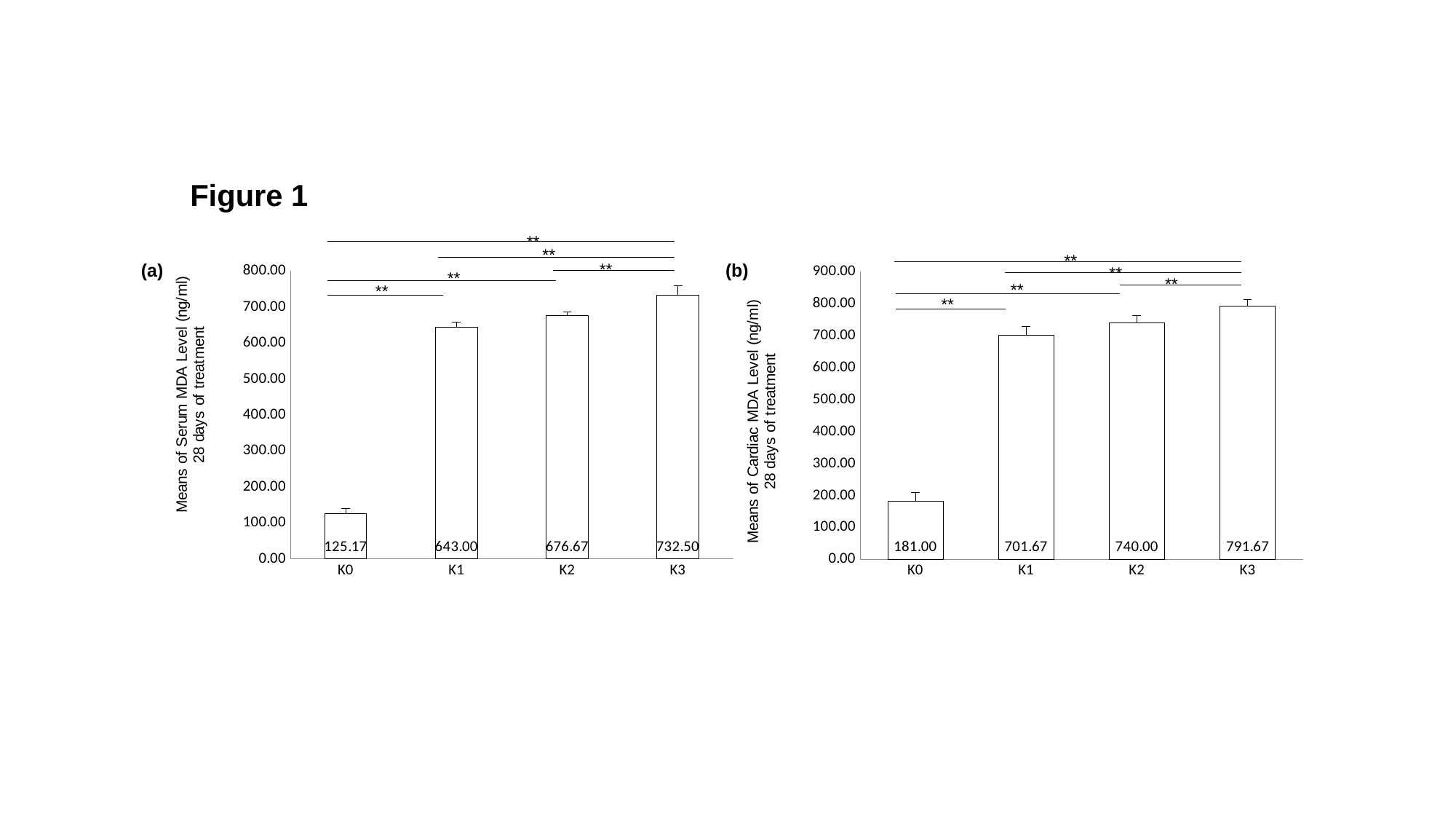
What kind of chart is chart (b), the cardiac MDA chart on the right? bar chart In chart (a), the serum MDA chart on the left, which is larger, the value for K2 or the value for K1? K2 How many categories are shown on the x axis of chart (a), the serum MDA chart on the left? 4 In chart (a), the serum MDA chart on the left, do the values rise or fall from K0 to K3? rise In chart (b), the cardiac MDA chart on the right, what is the value for K2? 740.00 What is the y-axis label of chart (b), the chart on the right? Means of Cardiac MDA Level (ng/ml) 28 days of treatment In chart (b), the cardiac MDA chart on the right, is the value for K0 greater or less than 300.00? less In chart (b), the cardiac MDA chart on the right, which category has the highest value? K3 In chart (a), the serum MDA chart on the left, which category has the lowest value? K0 In chart (b), the cardiac MDA chart on the right, what is the difference between the values for K3 and K1? 90.00 In chart (a), the serum MDA chart on the left, what is the value for K1? 643.00 In chart (a), the serum MDA chart on the left, what is the difference between the values for K3 and K0? 607.33